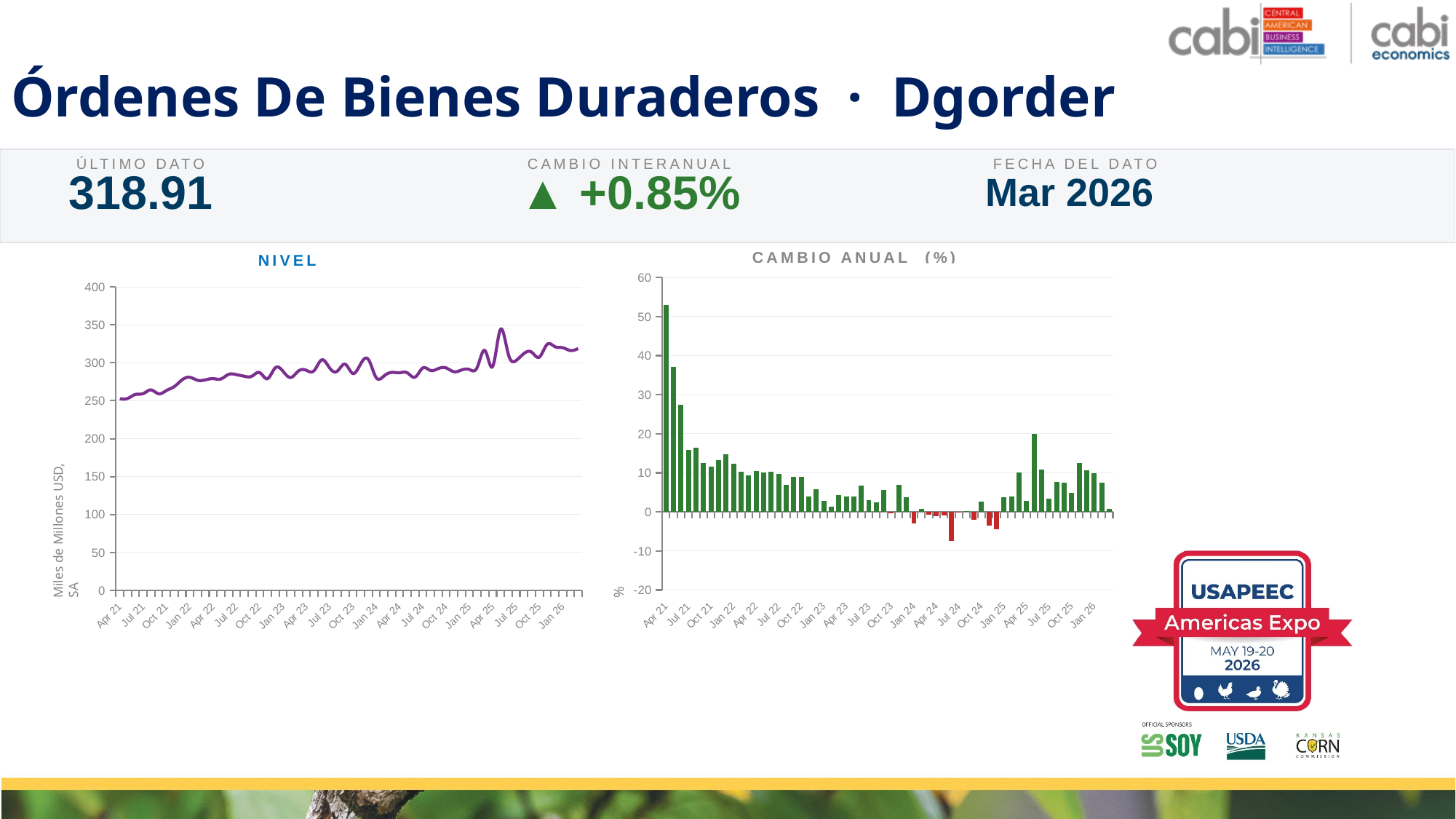
In the CAMBIO ANUAL (%) chart, which month has the lowest bar? Jun 24 In the CAMBIO ANUAL (%) chart, is the value for Apr 21 greater or less than 50? greater In the NIVEL chart, which is larger, the value for Apr 21 or the value for Jan 26? Jan 26 In the NIVEL chart, is the value for Jan 26 greater or less than 300? greater In the NIVEL chart, is the value for Apr 21 greater or less than 300? less In the NIVEL chart, do the values generally rise or fall from Apr 21 to Jan 26? rise What is the y-axis label of the NIVEL chart? Miles de Millones USD, SA What kind of chart is the CAMBIO ANUAL (%) chart on the right? bar chart In the CAMBIO ANUAL (%) chart, which month has the highest bar? Apr 21 What kind of chart is the NIVEL chart on the left? line chart What is the latest value (Último dato) shown for the series on the slide? 318.91